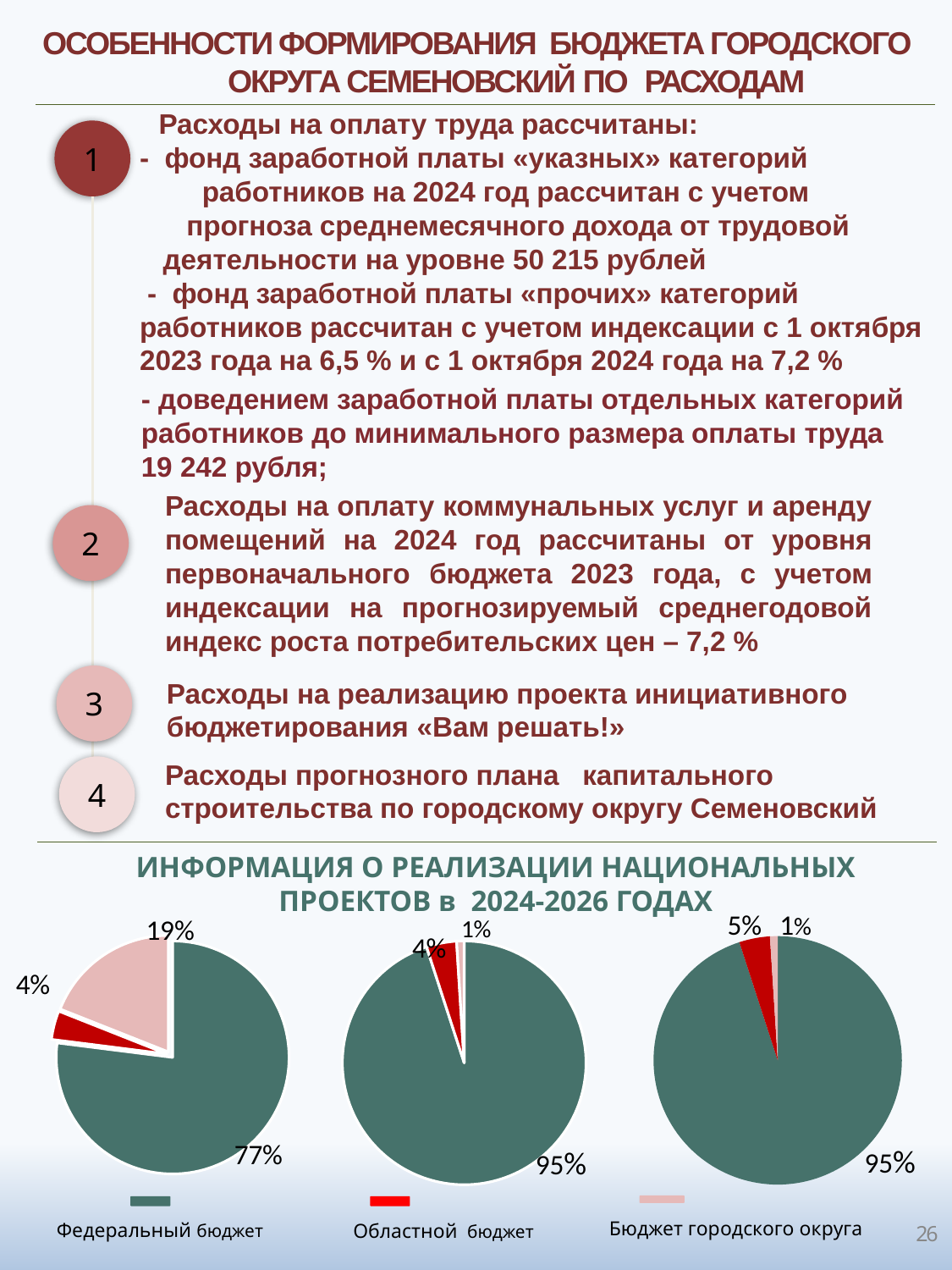
How many pie charts are shown on the slide? 3 In the middle pie chart, what share is labelled for the federal budget? 95% In the right pie chart, what share is labelled for the regional budget (Областной бюджет)? 5% What kind of charts are shown at the bottom of the slide? pie charts In the left pie chart, what share is labelled for the federal budget (Федеральный бюджет)? 77% How many entries does the legend below the pie charts list? 3 In the left pie chart, which budget source has the largest share? Федеральный бюджет In the middle pie chart, which budget source has the smallest share? Бюджет городского округа In the left pie chart, what is the difference between the federal budget share and the city district budget share? 58% Which colour represents the regional budget (Областной бюджет) in the pie charts? red In the left pie chart, what share is labelled for the city district budget (Бюджет городского округа)? 19% In the left pie chart, what share is labelled for the regional budget (Областной бюджет)? 4%